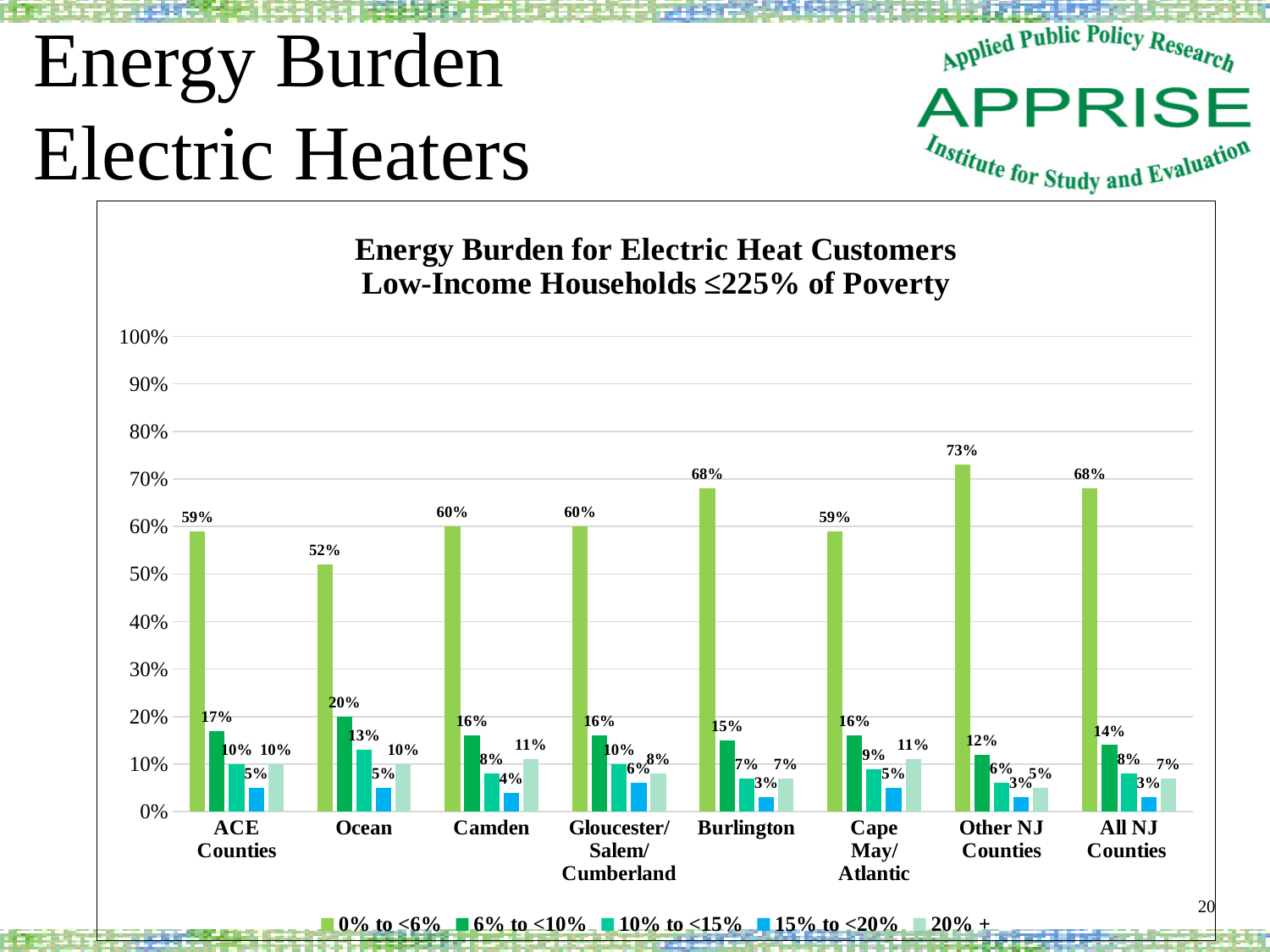
Which is larger: the "10% to <15%" value for Ocean or for Burlington? Ocean What is the value of the "15% to <20%" series for Gloucester/Salem/Cumberland? 6% What is the value of the "0% to <6%" series for Other NJ Counties? 73% What is the difference between the "0% to <6%" values for Other NJ Counties and Ocean? 21% What is the value of the "20% +" series for Camden? 11% How many categories are shown on the x axis? 8 What kind of chart is shown on the slide? Bar chart What is the title of the chart? Energy Burden for Electric Heat Customers Low-Income Households ≤225% of Poverty How many series does the legend list? 5 Which category has the lowest value for the "0% to <6%" series? Ocean Which category has the highest value for the "0% to <6%" series? Other NJ Counties What is the value of the "6% to <10%" series for Ocean? 20%